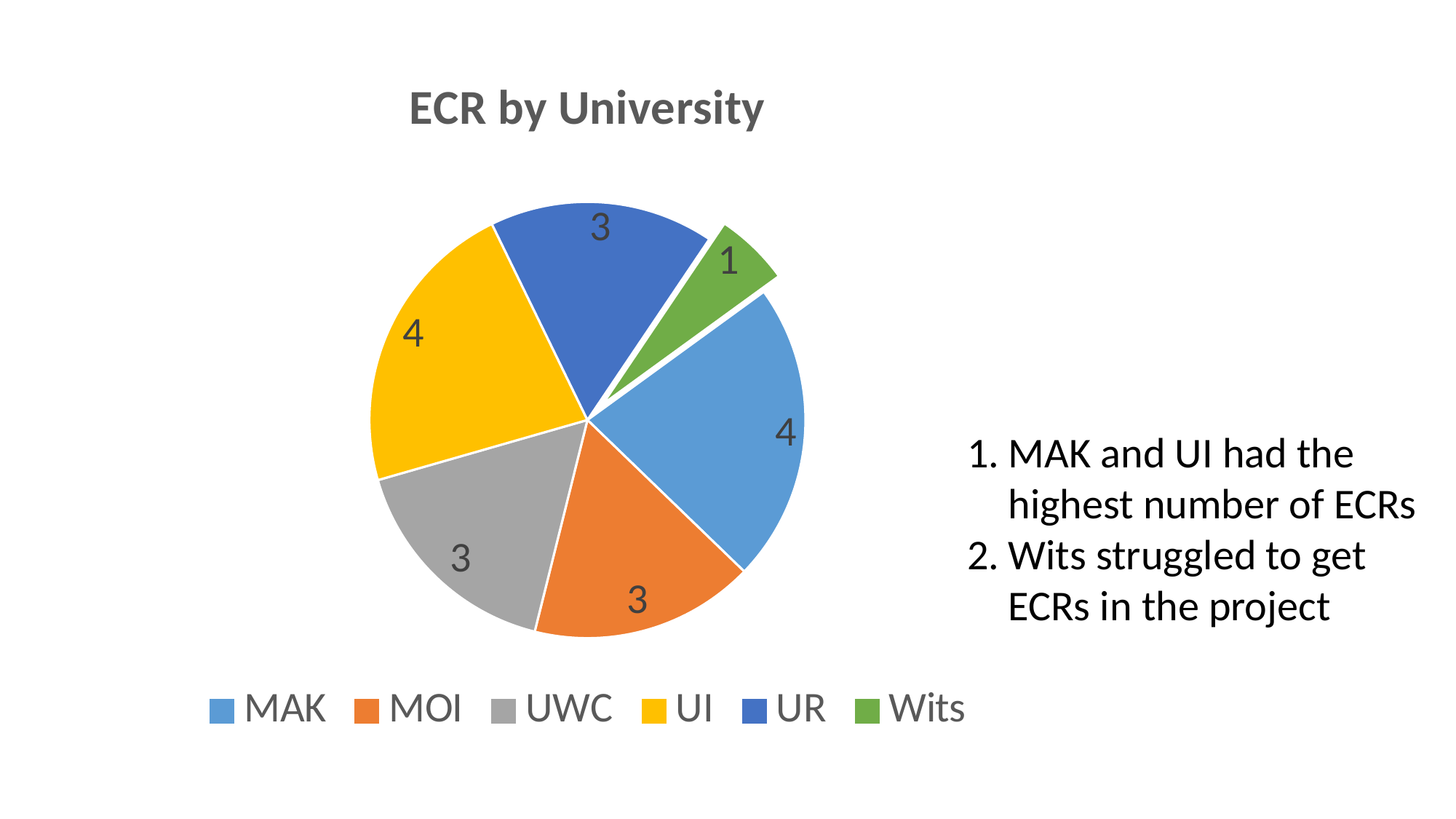
How many universities are shown in the ECR by University pie chart? 6 What is the value for UI in the ECR by University pie chart? 4 Which is larger in the ECR by University pie chart, the value for UI or the value for UR? UI Which universities share the largest slice in the ECR by University pie chart? MAK and UI Which university has the smallest slice in the ECR by University pie chart? Wits What kind of chart is shown on the slide? Pie chart What is the value for UWC in the ECR by University pie chart? 3 What is the value for Wits in the ECR by University pie chart? 1 What is the total of all slices in the ECR by University pie chart? 18 What is the difference between the values for MAK and Wits in the ECR by University pie chart? 3 What colour is the Wits slice in the ECR by University pie chart? Green What is the value for MAK in the ECR by University pie chart? 4